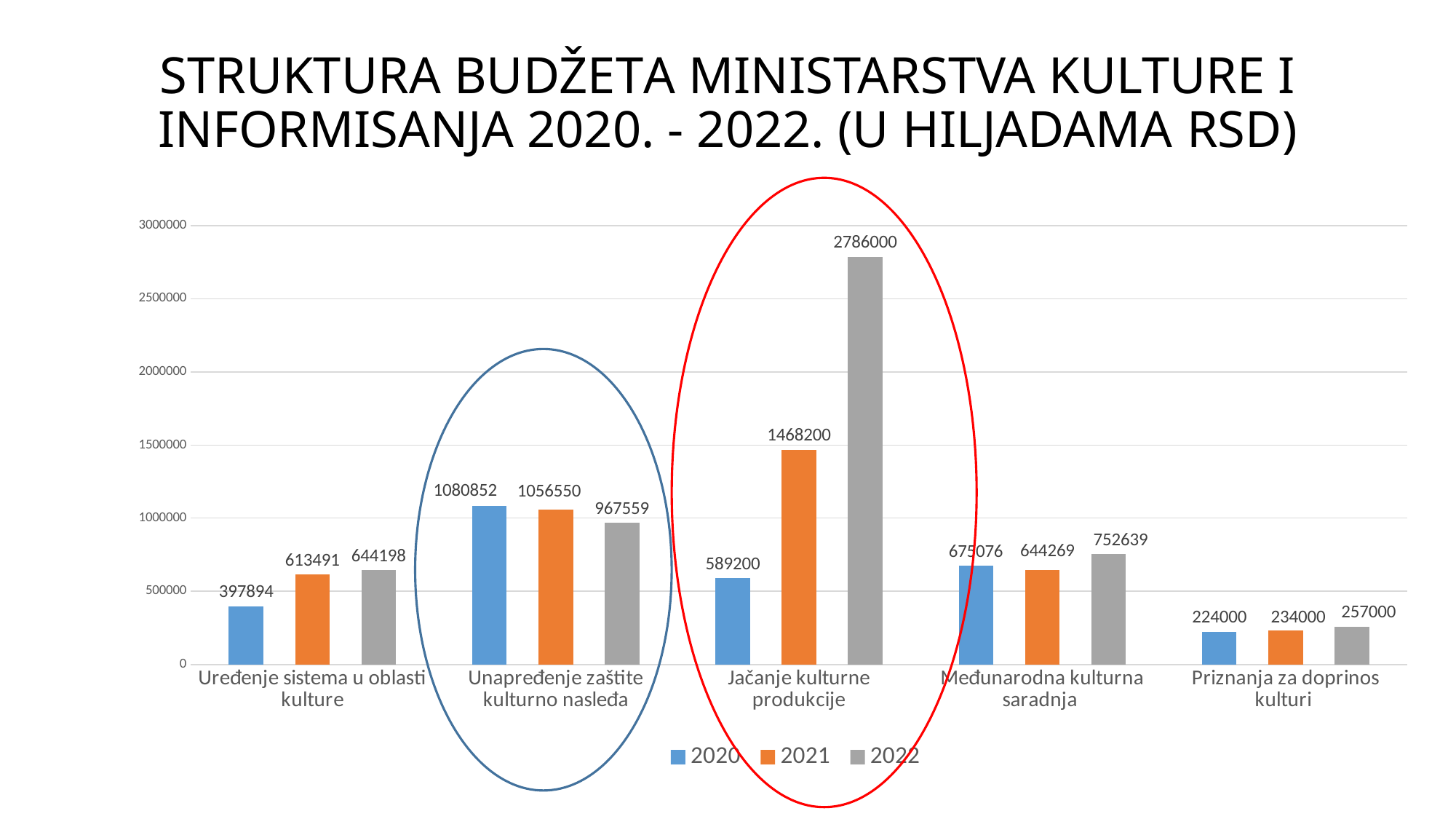
Which is larger for Unapređenje zaštite kulturno nasleđa: the 2020 value or the 2022 value? 2020 How many categories are shown on the x axis? 5 What kind of chart is shown on the slide? Bar chart What is the value for 2021 in the category Međunarodna kulturna saradnja? 644269 Which category has the lowest value for 2020? Priznanja za doprinos kulturi What is the difference between the 2022 and 2021 values for Jačanje kulturne produkcije? 1317800 How many series does the legend list? 3 What is the difference between the 2022 and 2020 values for Priznanja za doprinos kulturi? 33000 Which category has the highest value for 2022? Jačanje kulturne produkcije What is the value for 2022 in the category Jačanje kulturne produkcije? 2786000 Do the values for Unapređenje zaštite kulturno nasleđa rise or fall from 2020 to 2022? Fall What is the value for 2020 in the category Uređenje sistema u oblasti kulture? 397894